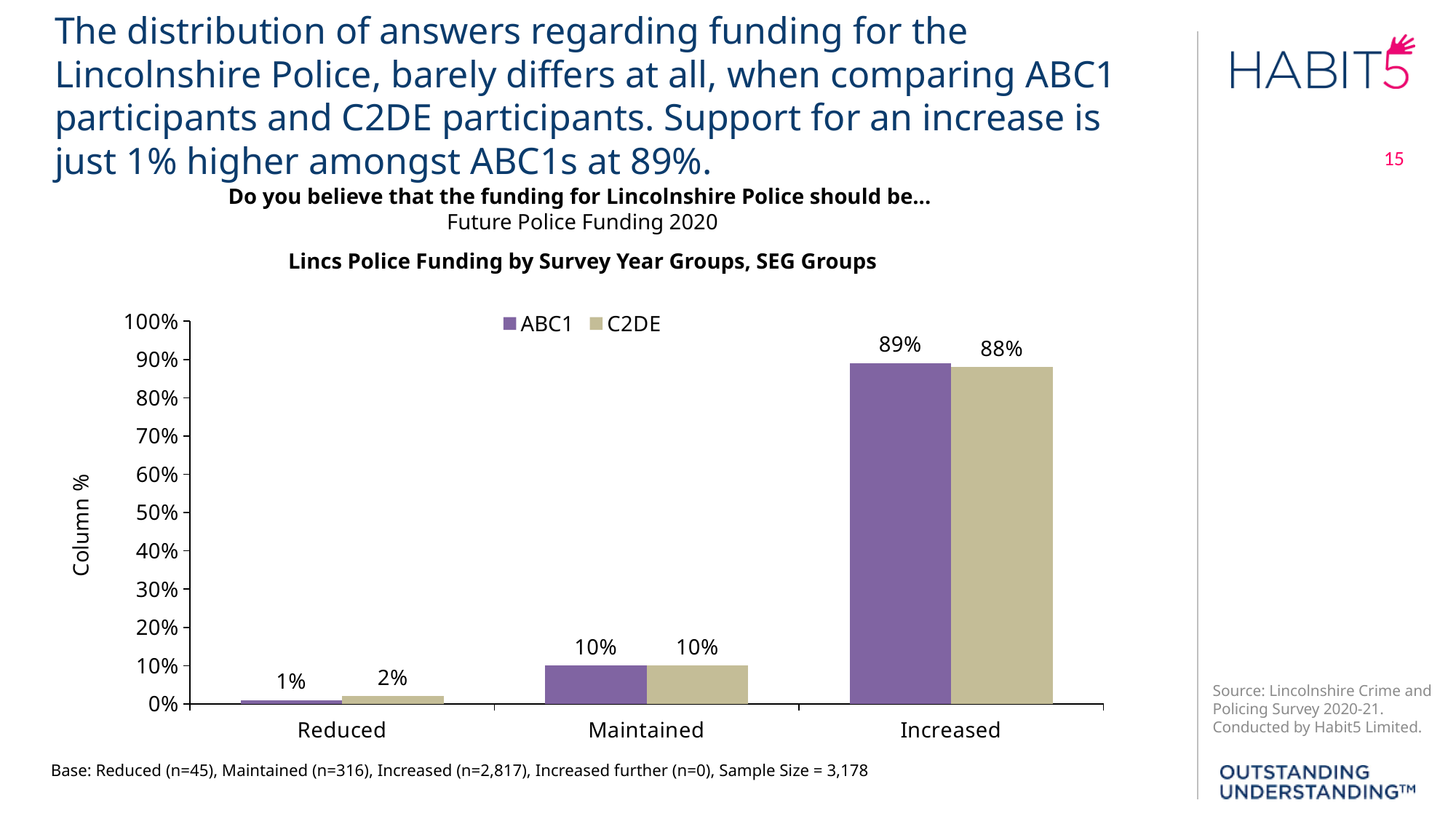
Is the value for C2DE in the Increased category greater or less than 80%? greater What is the difference between the ABC1 and C2DE values in the Increased category? 1% How many series does the legend list? 2 What is the value for C2DE in the Maintained category? 10% What is the value for ABC1 in the Increased category? 89% Which is larger in the Reduced category, the ABC1 value or the C2DE value? C2DE What is the label of the y axis? Column % Which category has the highest value for ABC1? Increased Which category has the lowest value for C2DE? Reduced What kind of chart is shown on the slide? bar chart What is the value for C2DE in the Reduced category? 2% How many categories are shown on the x axis? 3